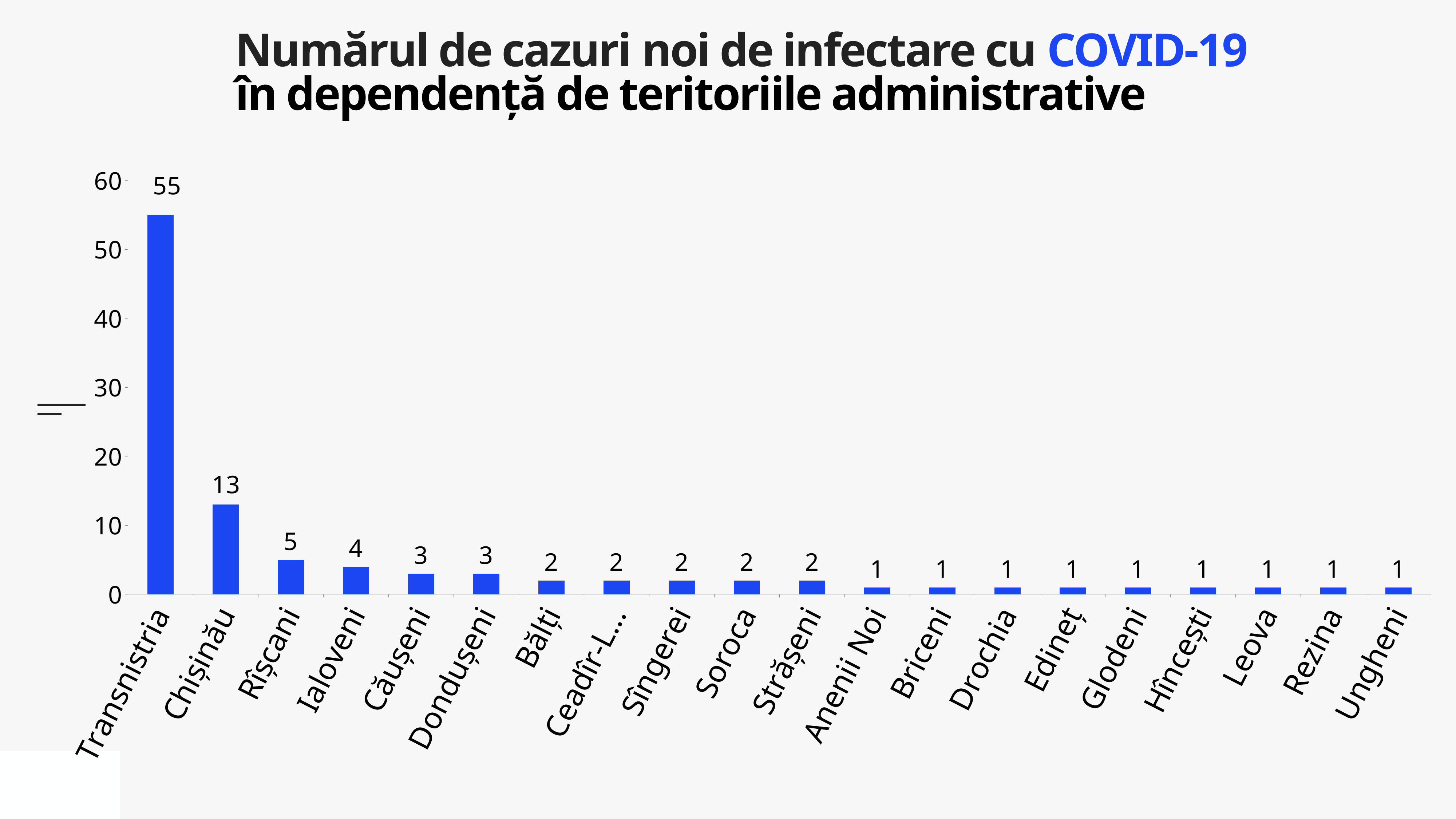
What is the value for Chișinău? 13 Which category has the highest value? Transnistria How many categories are shown on the x axis? 20 What is the value for Transnistria? 55 What is the difference between the values for Rîșcani and Căușeni? 2 Do the values rise or fall from left to right along the x axis? fall What is the value for Soroca? 2 What is the value for Ialoveni? 4 What kind of chart is shown on the slide? bar chart Which is larger, the value for Chișinău or the value for Rîșcani? Chișinău What is the difference between the values for Transnistria and Chișinău? 42 What is the value for Rîșcani? 5